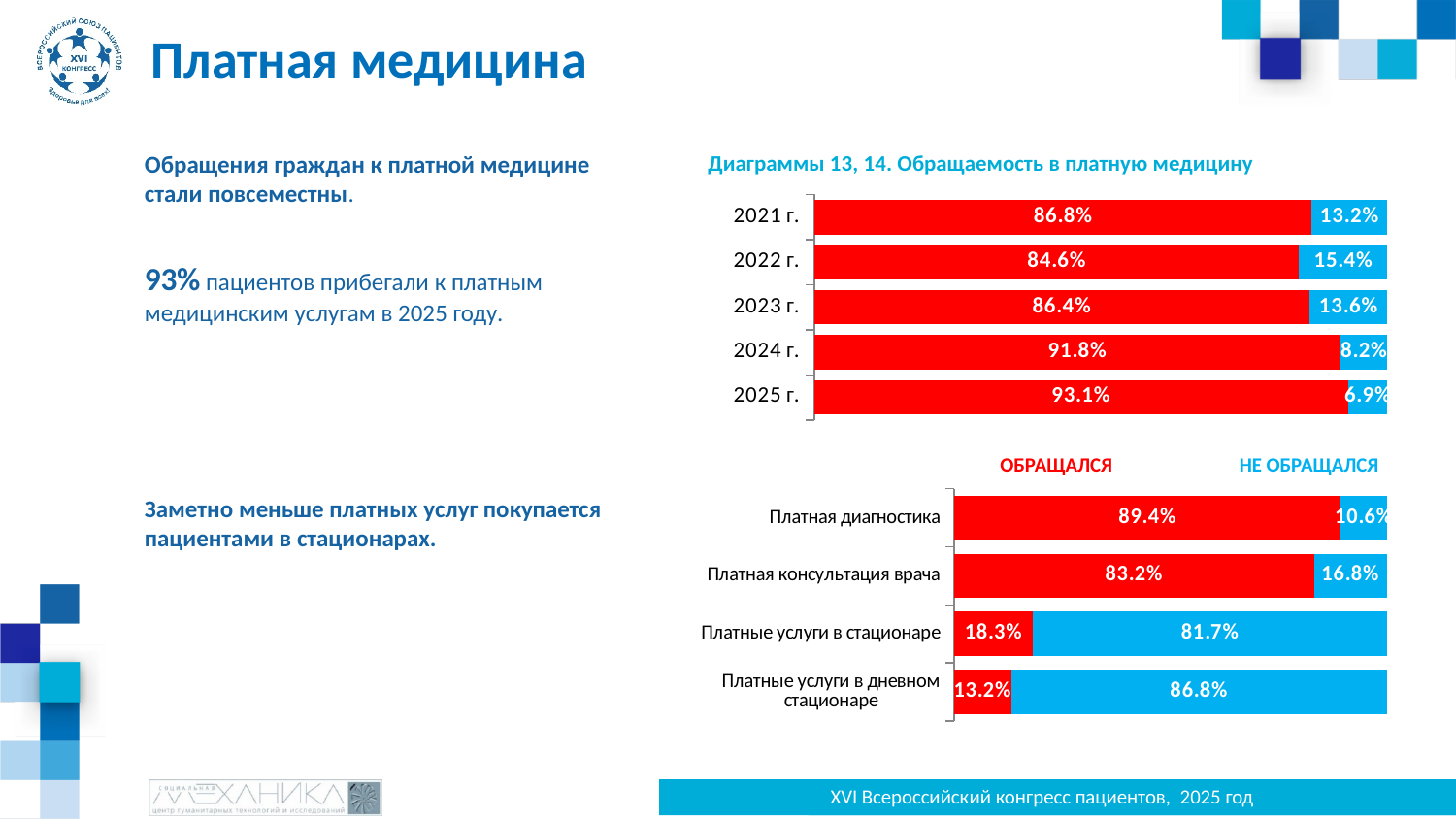
How many series does the legend list for the charts? 2 In the top chart (by year), which year has the highest 'ОБРАЩАЛСЯ' share? 2025 г. In the top chart (by year), which year has the lowest 'ОБРАЩАЛСЯ' share? 2022 г. In the top chart (by year), what is the red 'ОБРАЩАЛСЯ' value for 2025 г.? 93.1% In the bottom chart (by service type), what is the 'ОБРАЩАЛСЯ' value for 'Платные услуги в стационаре'? 18.3% In the bottom chart (by service type), which is larger: the 'ОБРАЩАЛСЯ' value for 'Платная консультация врача' or for 'Платные услуги в дневном стационаре'? Платная консультация врача In the top chart (by year), does the 'НЕ ОБРАЩАЛСЯ' share rise or fall from 2023 г. to 2025 г.? fall In the top chart (by year), what is the difference between the 'ОБРАЩАЛСЯ' values for 2025 г. and 2021 г.? 6.3% In the top chart (by year), what is the blue 'НЕ ОБРАЩАЛСЯ' value for 2022 г.? 15.4% In the top chart (by year), how many years are shown? 5 In the bottom chart (by service type), which category has the highest 'ОБРАЩАЛСЯ' share? Платная диагностика In the bottom chart (by service type), what is the 'НЕ ОБРАЩАЛСЯ' value for 'Платная диагностика'? 10.6%